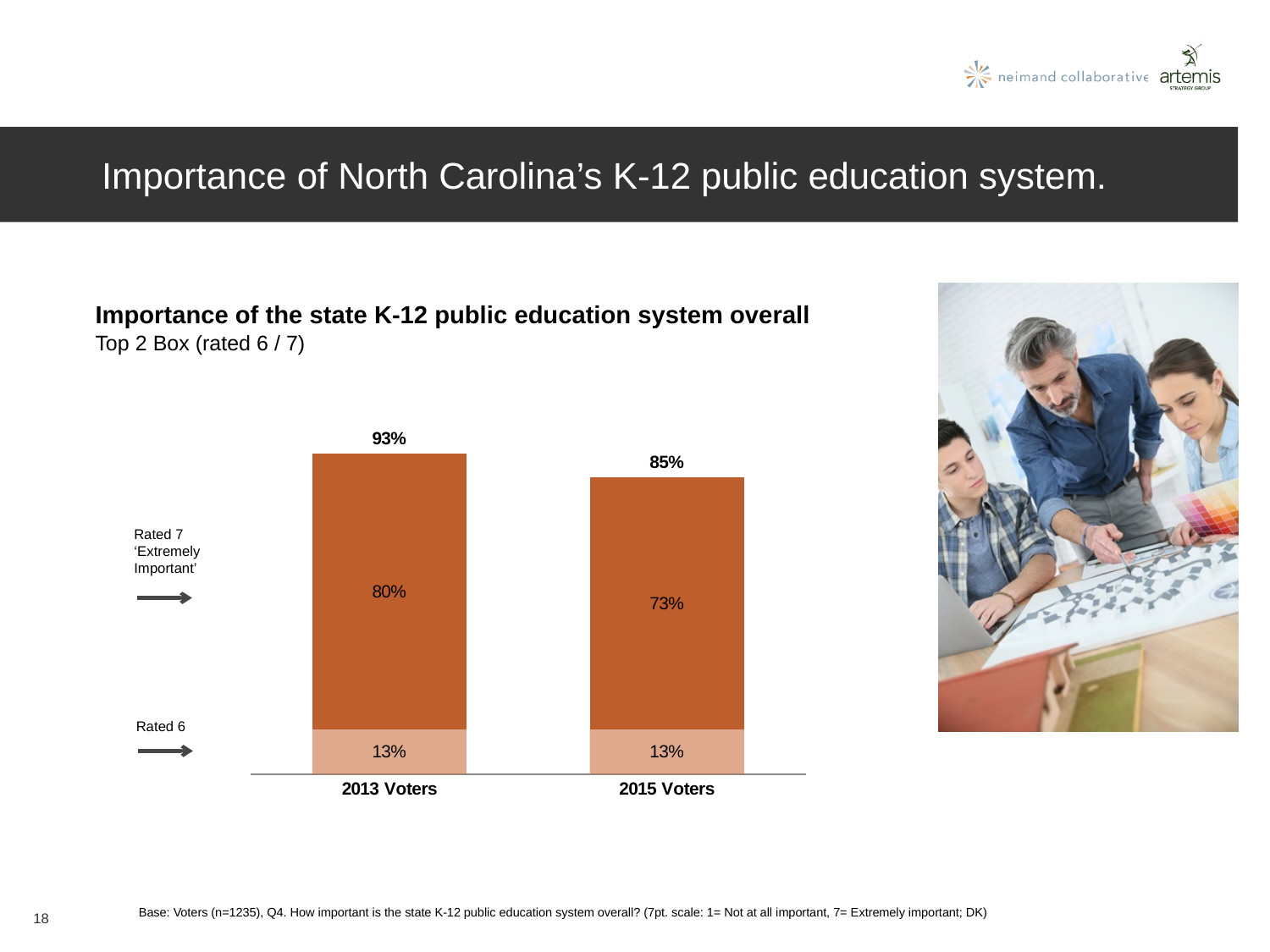
How many voter groups (bars) are shown in the chart? 2 What is the title of the chart on the slide? Importance of the state K-12 public education system overall By how many percentage points did the 'Rated 7' share fall from 2013 Voters to 2015 Voters? 7 Does the Top 2 Box total rise or fall from 2013 Voters to 2015 Voters? Fall What percentage of 2013 Voters rated the state K-12 public education system a 7 ('Extremely Important')? 80% What is the difference in Top 2 Box totals between 2013 Voters and 2015 Voters? 8 What is the Top 2 Box total for 2013 Voters? 93% What is the Top 2 Box total for 2015 Voters? 85% What percentage of 2015 Voters rated the state K-12 public education system a 6? 13% Which group has the higher Top 2 Box total, 2013 Voters or 2015 Voters? 2013 Voters What type of chart is shown on the slide? Stacked bar chart What percentage of 2015 Voters rated the state K-12 public education system a 7 ('Extremely Important')? 73%